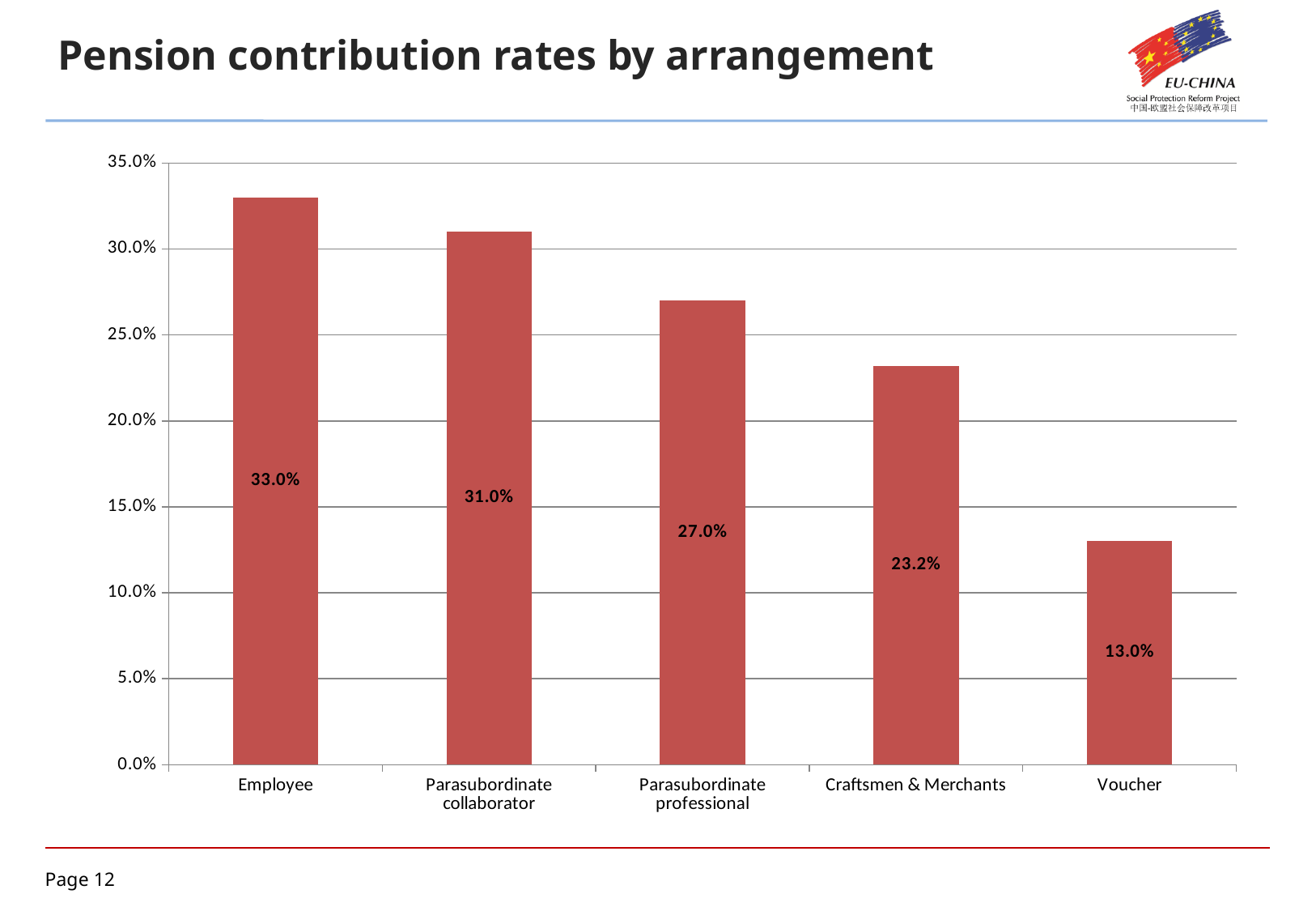
What is the pension contribution rate for Voucher? 13.0% Which arrangement has the highest pension contribution rate? Employee Is the value for Craftsmen & Merchants greater or less than 25.0%? less What is the difference between the contribution rates for Parasubordinate professional and Voucher? 14.0% What is the pension contribution rate for Craftsmen & Merchants? 23.2% What kind of chart is shown on the slide? Bar chart How many arrangements are shown on the chart? 5 Which arrangement has the lowest pension contribution rate? Voucher What is the difference between the contribution rates for Employee and Parasubordinate collaborator? 2.0% Which has a higher contribution rate, Parasubordinate professional or Craftsmen & Merchants? Parasubordinate professional Do the contribution rates rise or fall from left to right across the arrangements? Fall What is the pension contribution rate for Employee? 33.0%